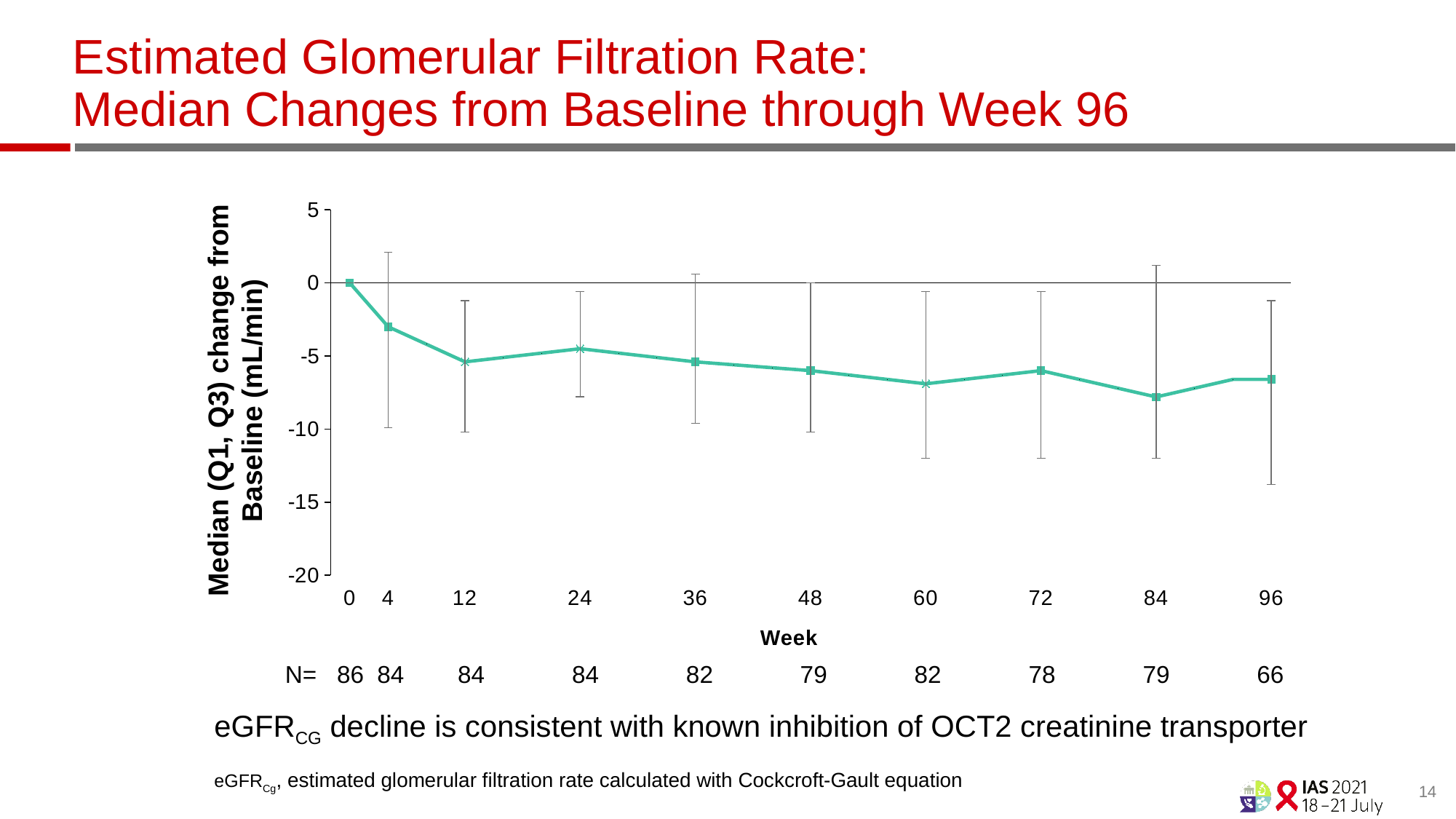
How many time points (weeks) are plotted on the x axis? 10 What kind of chart is shown on the slide? line chart What is the median change from baseline at week 0? 0 At which week is the plotted median change from baseline highest? 0 Overall, do the plotted median values rise or fall from week 0 to week 96? fall Is the median change from baseline at week 4 greater or less than -5? greater What is the label of the x axis? Week Is the median change from baseline at week 96 greater or less than -5? less What is the N value shown for week 48? 79 What is the N value shown for week 96? 66 At which week is the plotted median change from baseline lowest? 84 Is the median change from baseline at week 84 greater or less than -5? less